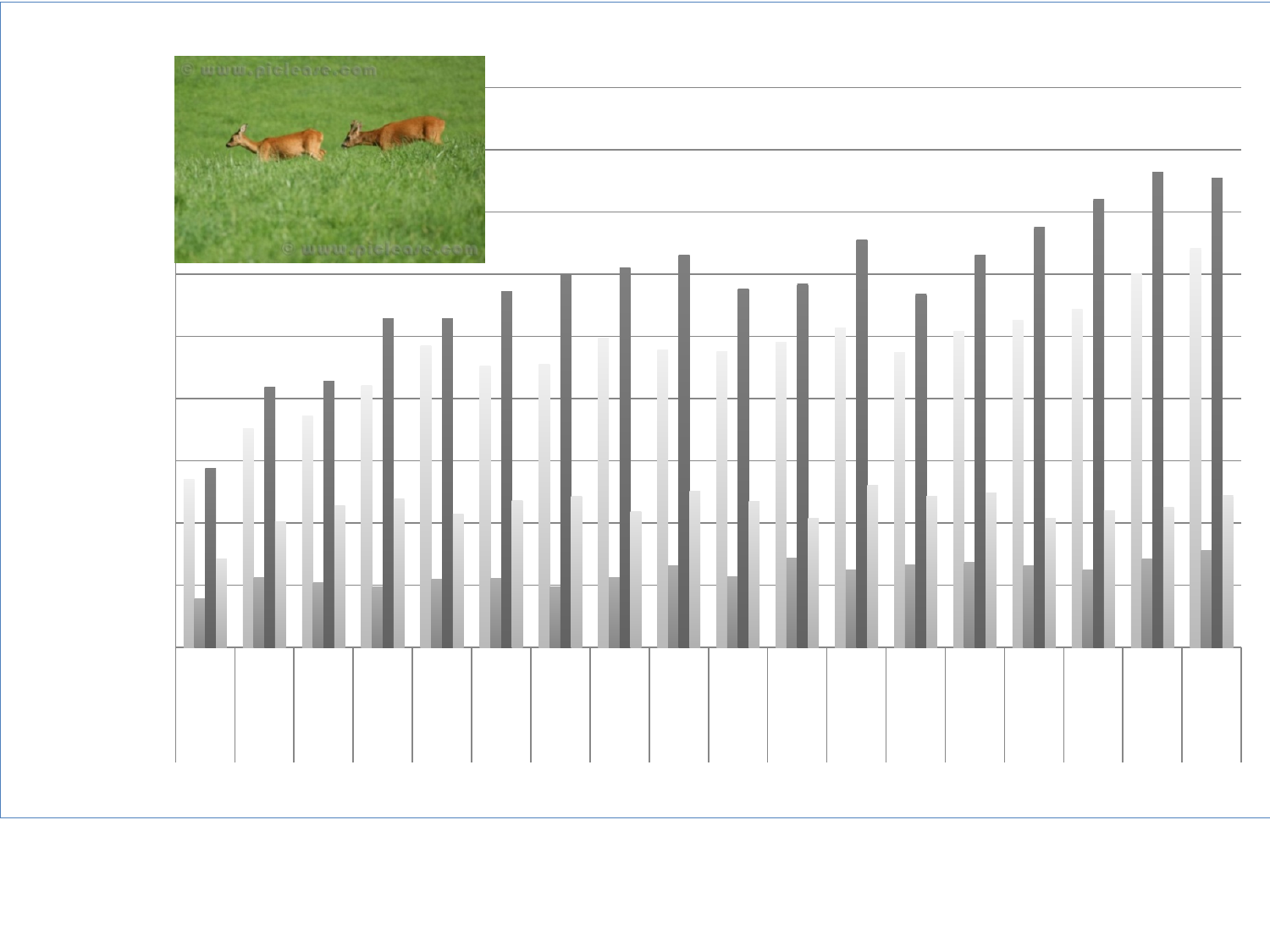
Does the chart display a legend? No What kind of chart is shown on the slide? bar chart Do the tallest (dark grey) bars generally rise or fall from left to right along the x axis? rise Are the bars in the chart vertical or horizontal? vertical How many bars are there in each group along the x axis? 4 How many groups of bars are plotted along the x axis? 18